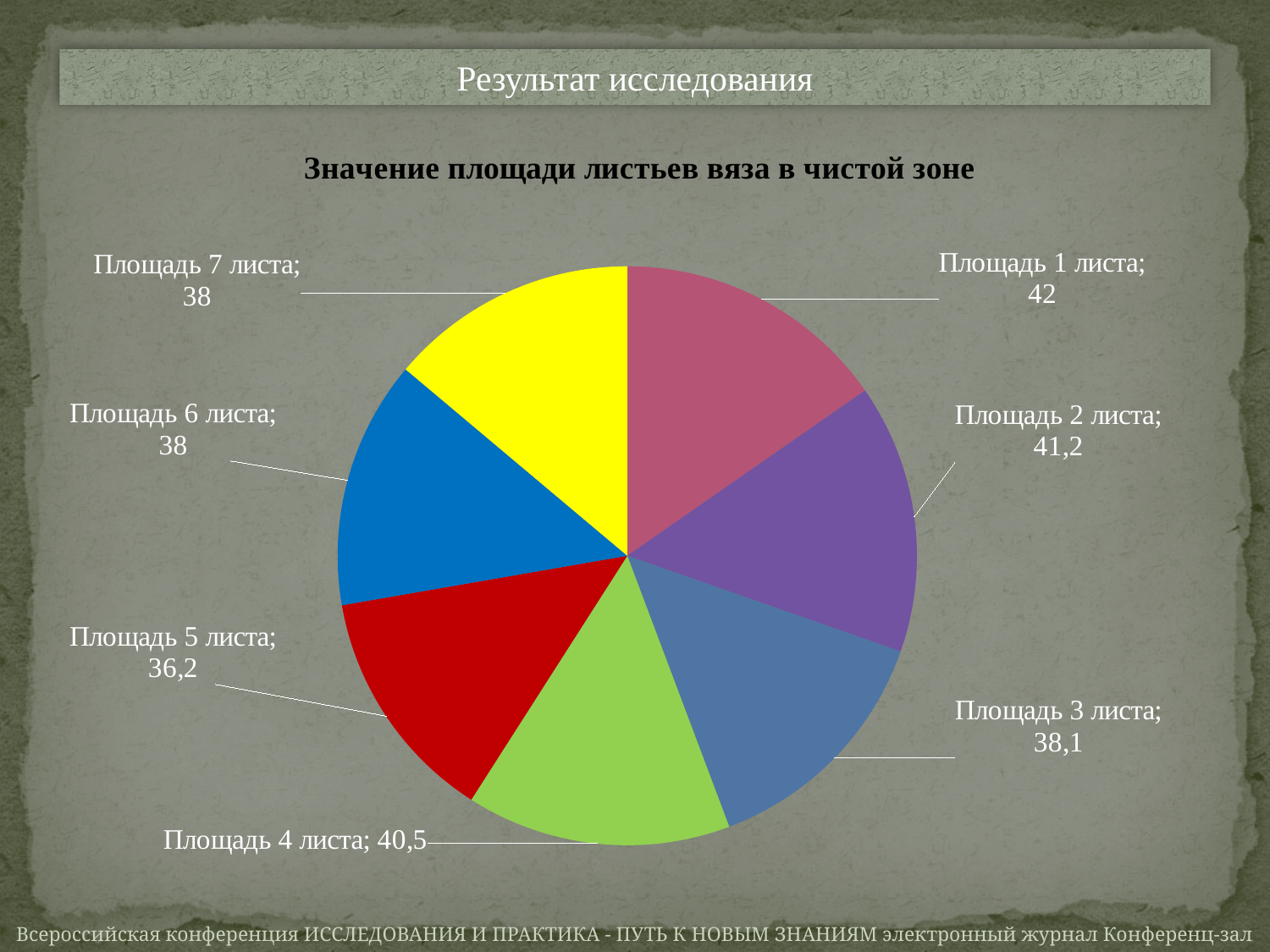
What is the value for Площадь 5 листа? 36,2 What is the difference between the values for Площадь 1 листа and Площадь 5 листа? 5,8 What is the value for Площадь 4 листа? 40,5 What is the title of the chart? Значение площади листьев вяза в чистой зоне How many slices does the pie chart have? 7 What is the value for Площадь 3 листа? 38,1 What is the value for Площадь 1 листа? 42 What colour is the slice for Площадь 7 листа? yellow Which is larger, the value for Площадь 2 листа or Площадь 4 листа? Площадь 2 листа What kind of chart is shown on the slide? pie chart Which category has the highest value? Площадь 1 листа Which category has the lowest value? Площадь 5 листа